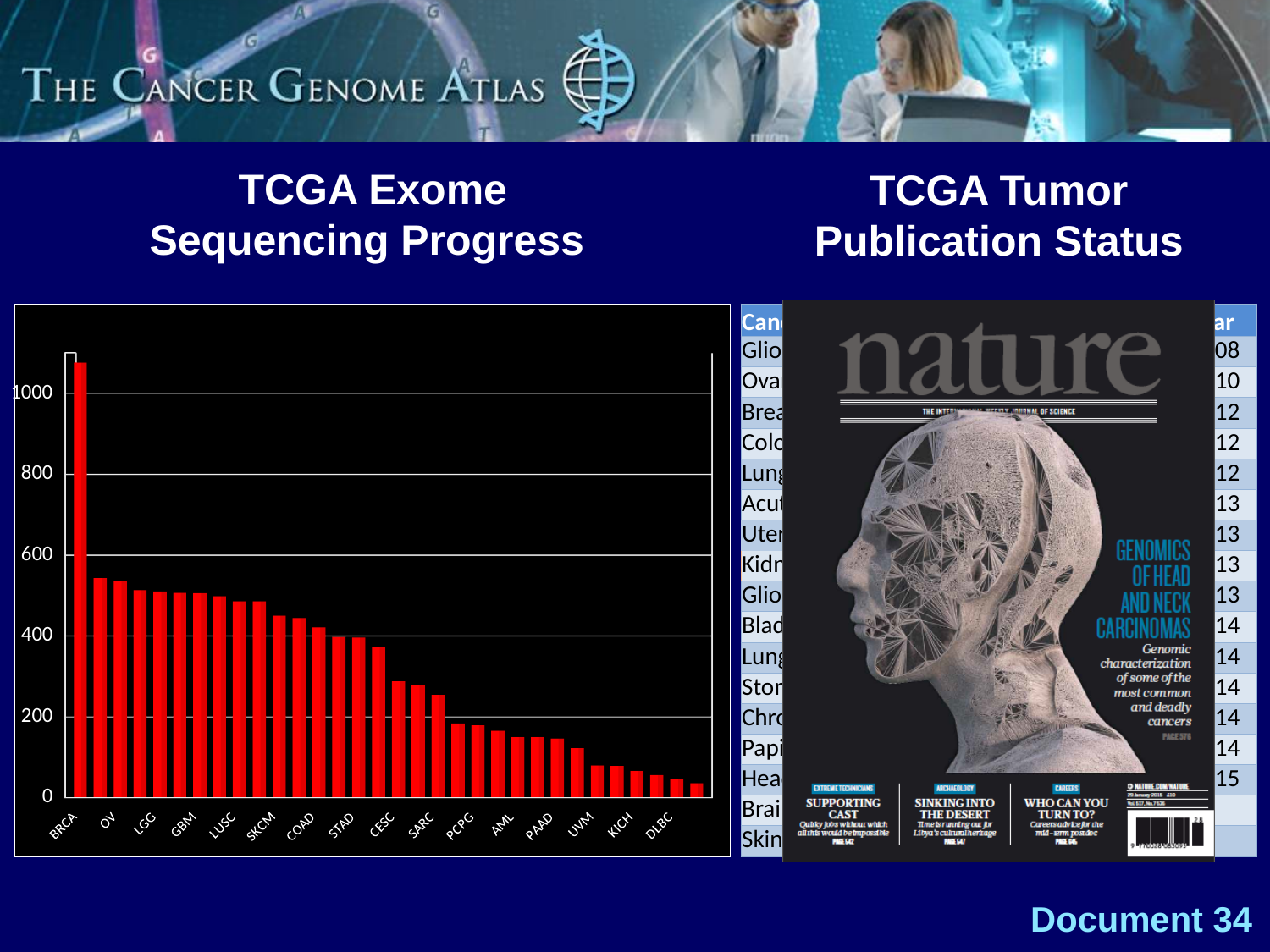
What kind of chart is shown under the title 'TCGA Exome Sequencing Progress'? bar chart In the TCGA Exome Sequencing Progress chart, is the value for BRCA greater or less than 1000? greater In the TCGA Exome Sequencing Progress chart, is the value for OV greater or less than 600? less In the TCGA Exome Sequencing Progress chart, which is larger, the value for LGG or the value for UVM? LGG In the TCGA Exome Sequencing Progress chart, is the value for PCPG greater or less than 200? less In the TCGA Exome Sequencing Progress chart, which is larger, the value for BRCA or the value for OV? BRCA What colour are the bars in the TCGA Exome Sequencing Progress chart? red In the TCGA Exome Sequencing Progress chart, which category has the highest value? BRCA In the TCGA Exome Sequencing Progress chart, do the values rise or fall from left to right along the x axis? fall